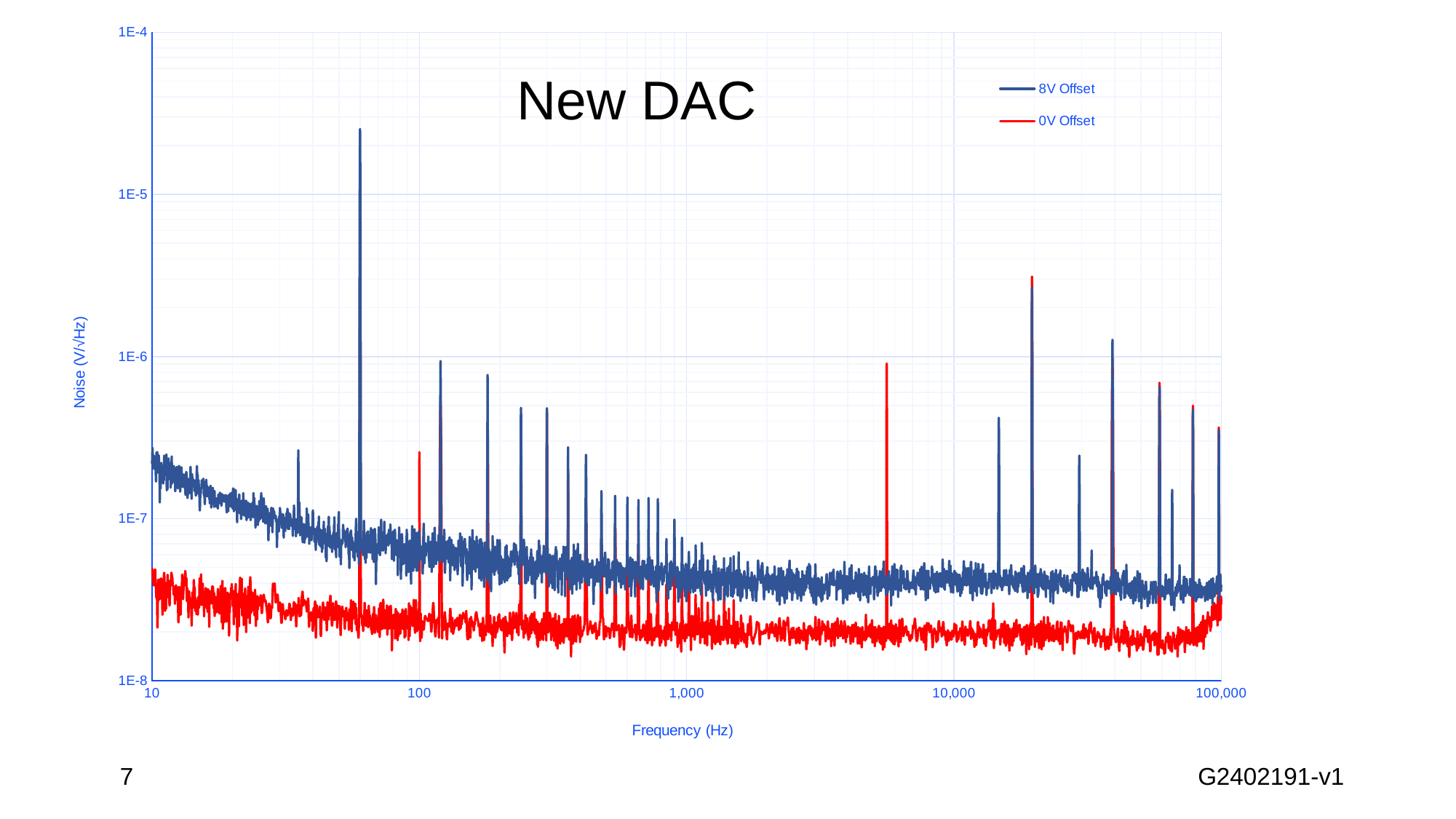
What kind of chart is shown on the slide? line chart Is the 0V Offset noise at 10 Hz greater or less than 1E-7? less Is the 8V Offset noise floor at 1,000 Hz greater or less than 1E-7? less Is the tallest 8V Offset spike (near 60 Hz) greater or less than 1E-5? greater How many series does the legend list? 2 Which series has the lower noise floor across the frequency range, 8V Offset or 0V Offset? 0V Offset Which series is drawn in red? 0V Offset What is the title of the chart? New DAC Which series has the higher noise level at 10 Hz, 8V Offset or 0V Offset? 8V Offset Does the 8V Offset noise floor rise or fall as frequency increases from 10 Hz to 1,000 Hz? fall